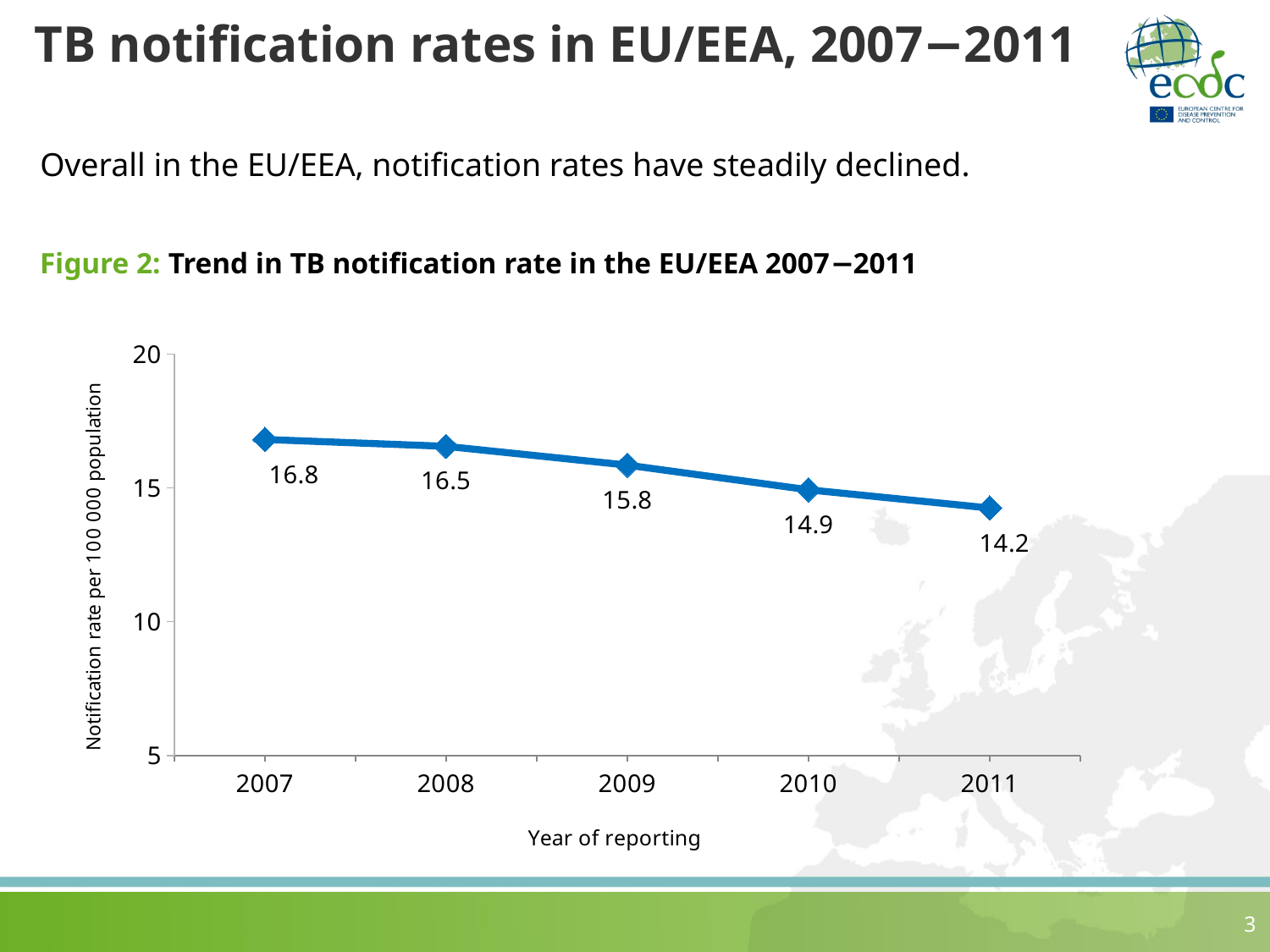
Which year had the lowest TB notification rate? 2011 Is the notification rate for 2010 greater or less than 15? less What kind of chart is shown on the slide? Line chart What was the TB notification rate per 100 000 population in 2009? 15.8 Does the TB notification rate rise or fall from 2007 to 2011? Fall What was the TB notification rate per 100 000 population in 2011? 14.2 Which year had the highest TB notification rate? 2007 By how much did the TB notification rate fall between 2007 and 2011? 2.6 How many years of reporting are plotted on the chart? 5 What was the TB notification rate per 100 000 population in the EU/EEA in 2007? 16.8 Which year had a higher notification rate, 2008 or 2010? 2008 What is the difference between the notification rates in 2009 and 2010? 0.9